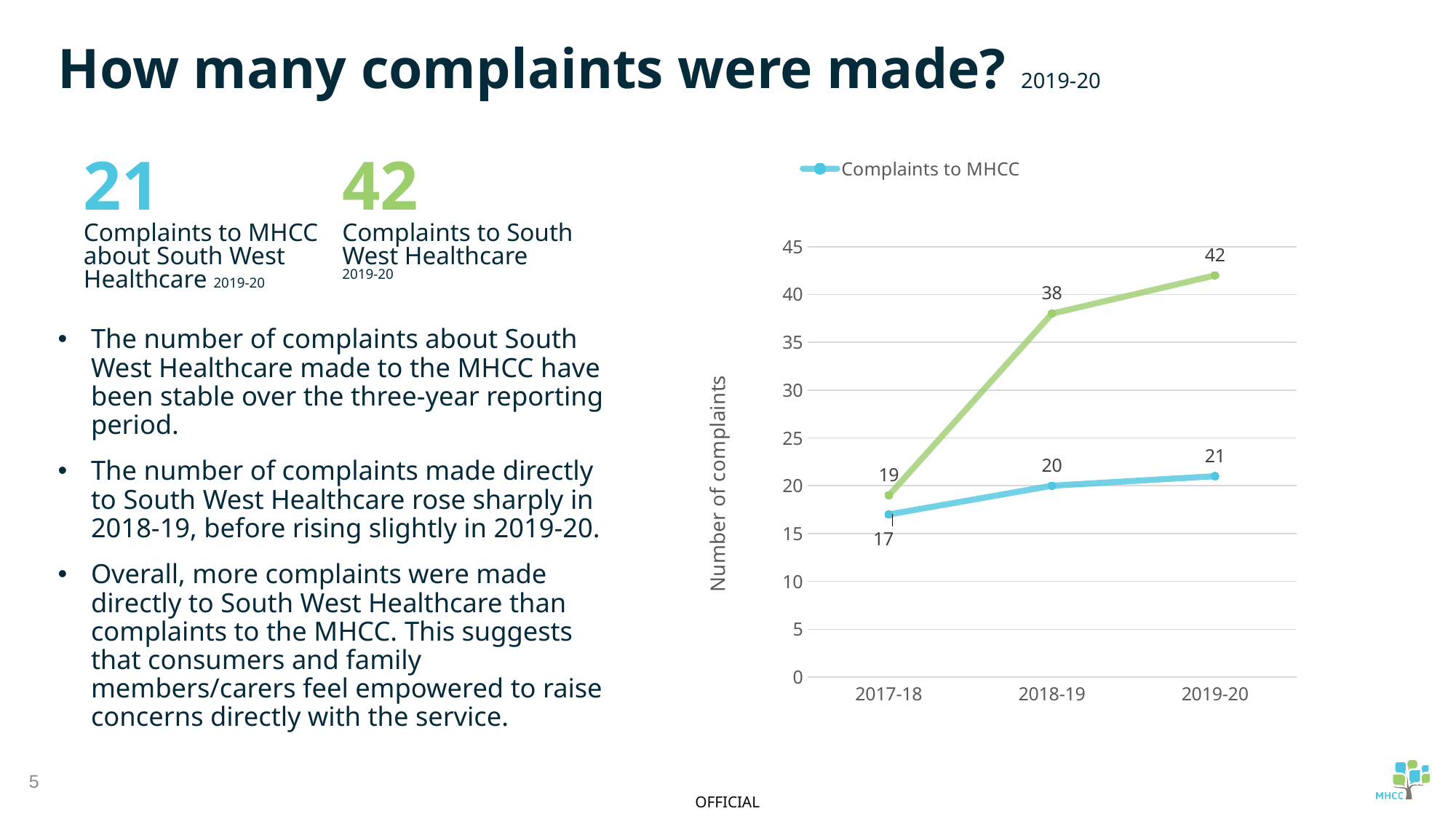
Does the Complaints to MHCC line rise or fall from 2017-18 to 2019-20? Rise What is the value of the green line in 2017-18? 19 In which year is Complaints to MHCC at its lowest? 2017-18 Which is larger in 2018-19: the green line or Complaints to MHCC? The green line What is the value of the green line in 2018-19? 38 What kind of chart is shown? Line chart What is the difference between the green line and Complaints to MHCC in 2019-20? 21 How many years are shown on the x axis? 3 What is the value for Complaints to MHCC in 2019-20? 21 By how much did the green line increase from 2017-18 to 2018-19? 19 In which year is the green line at its highest? 2019-20 What is the value for Complaints to MHCC in 2017-18? 17